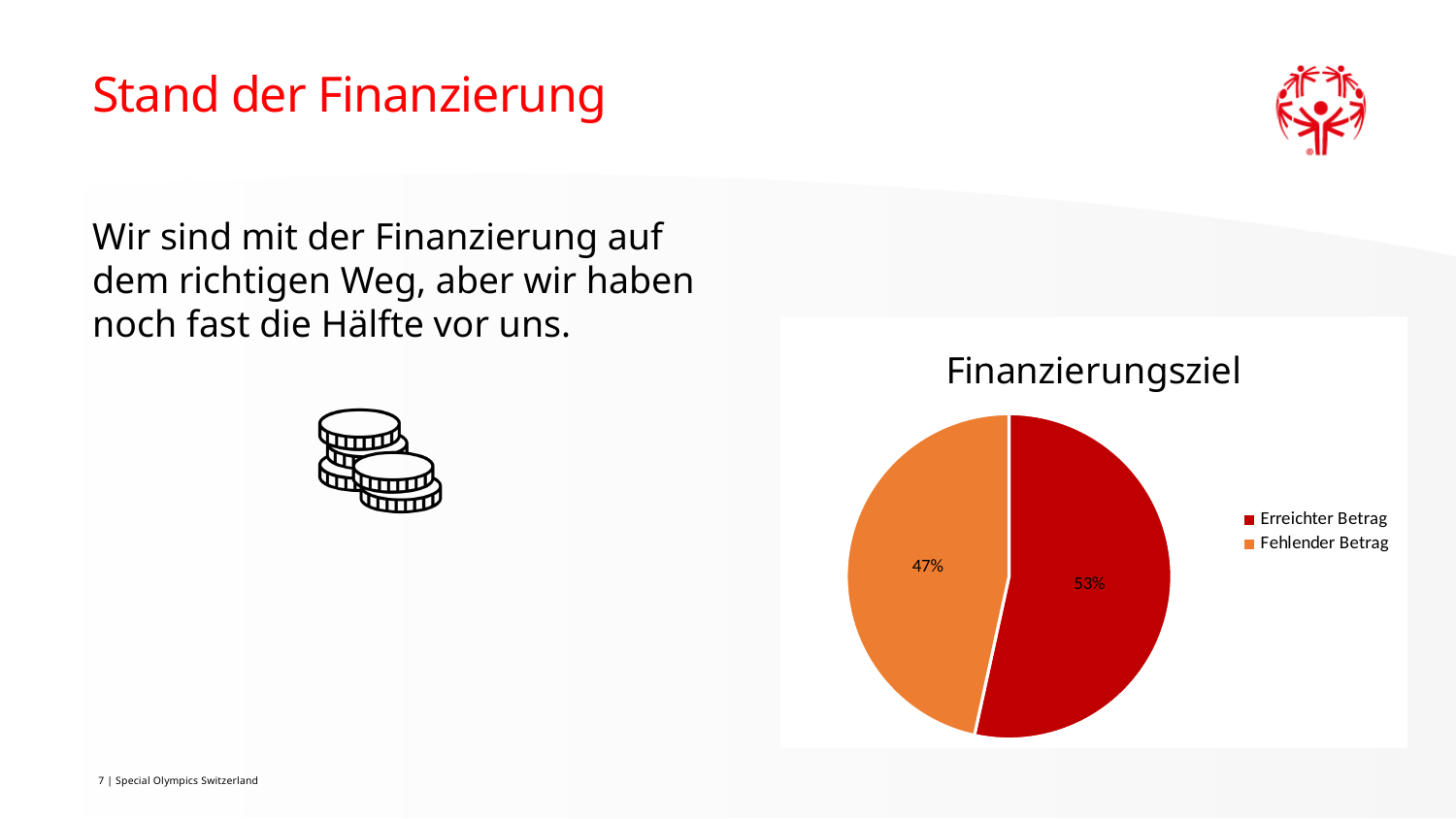
Is the share for Erreichter Betrag greater or less than 50%? greater What kind of chart is shown on the slide? pie chart What share of the pie does Fehlender Betrag represent? 47% Which slice is the largest in the pie chart? Erreichter Betrag Which is larger, Erreichter Betrag or Fehlender Betrag? Erreichter Betrag What is the title of the chart? Finanzierungsziel Which slice is the smallest in the pie chart? Fehlender Betrag What share of the pie does Erreichter Betrag represent? 53% How many entries does the legend list? 2 How many slices does the pie chart have? 2 What is the difference in percentage points between Erreichter Betrag and Fehlender Betrag? 6 Which legend entry is shown in orange? Fehlender Betrag